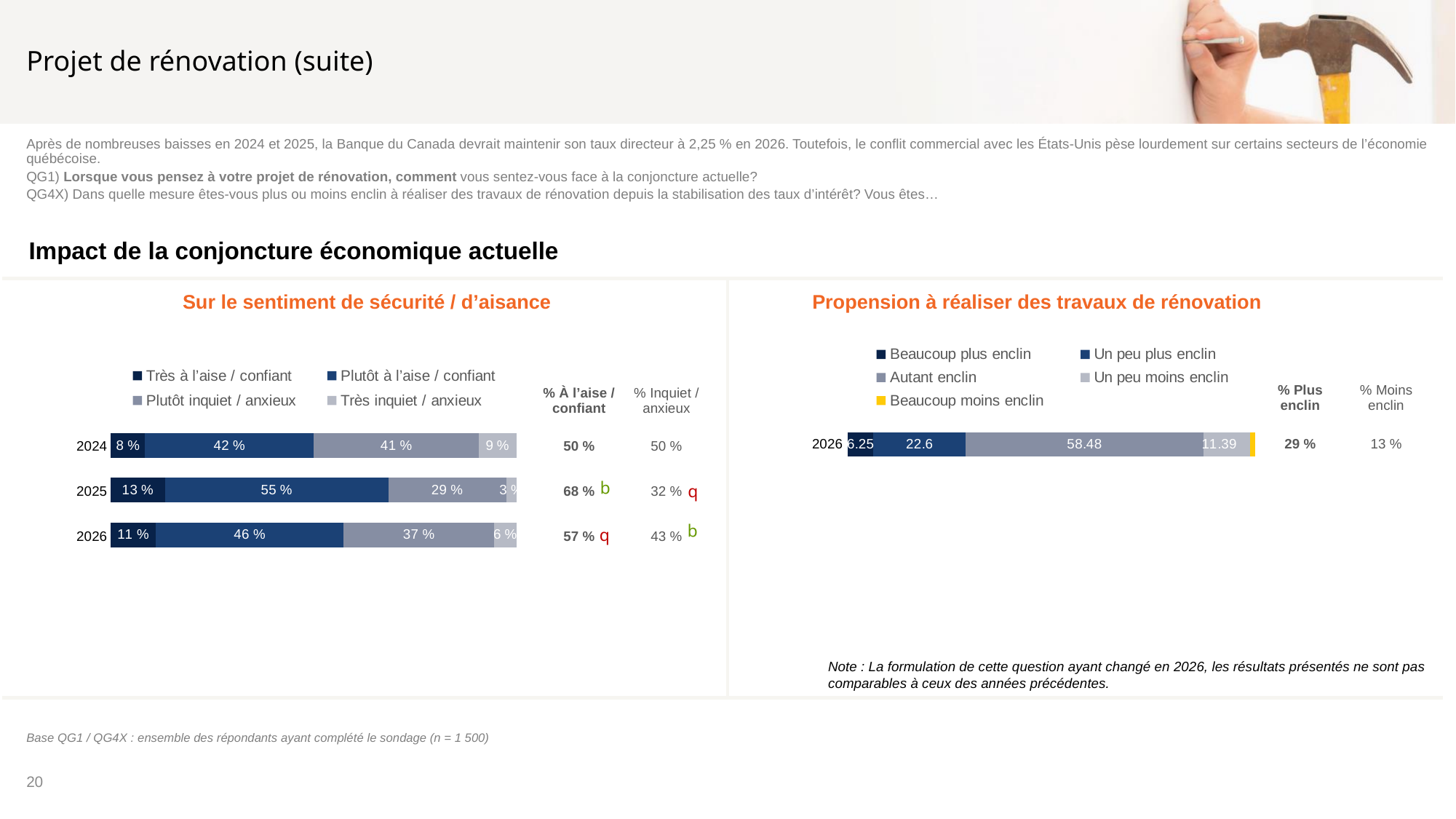
In the chart 'Sur le sentiment de sécurité / d'aisance', what is the value for 'Très à l'aise / confiant' in 2024? 8 % In the chart 'Sur le sentiment de sécurité / d'aisance', what is the difference between the 'Plutôt inquiet / anxieux' values for 2024 and 2025? 12 % How many series does the legend of the chart 'Sur le sentiment de sécurité / d'aisance' list? 4 In the chart 'Propension à réaliser des travaux de rénovation', what is the value for 'Autant enclin' in 2026? 58.48 In the chart 'Sur le sentiment de sécurité / d'aisance', what is the value for 'Plutôt à l'aise / confiant' in 2025? 55 % How many years are shown in the chart 'Sur le sentiment de sécurité / d'aisance'? 3 In the chart 'Sur le sentiment de sécurité / d'aisance', which year has the highest value for 'Plutôt à l'aise / confiant'? 2025 In the chart 'Sur le sentiment de sécurité / d'aisance', is the 'Très à l'aise / confiant' value larger in 2025 or in 2026? 2025 What kind of chart is 'Propension à réaliser des travaux de rénovation'? Stacked bar chart How many series does the legend of the chart 'Propension à réaliser des travaux de rénovation' list? 5 In the chart 'Sur le sentiment de sécurité / d'aisance', what is the value for 'Plutôt inquiet / anxieux' in 2026? 37 % In the chart 'Sur le sentiment de sécurité / d'aisance', which year has the lowest value for 'Très inquiet / anxieux'? 2025